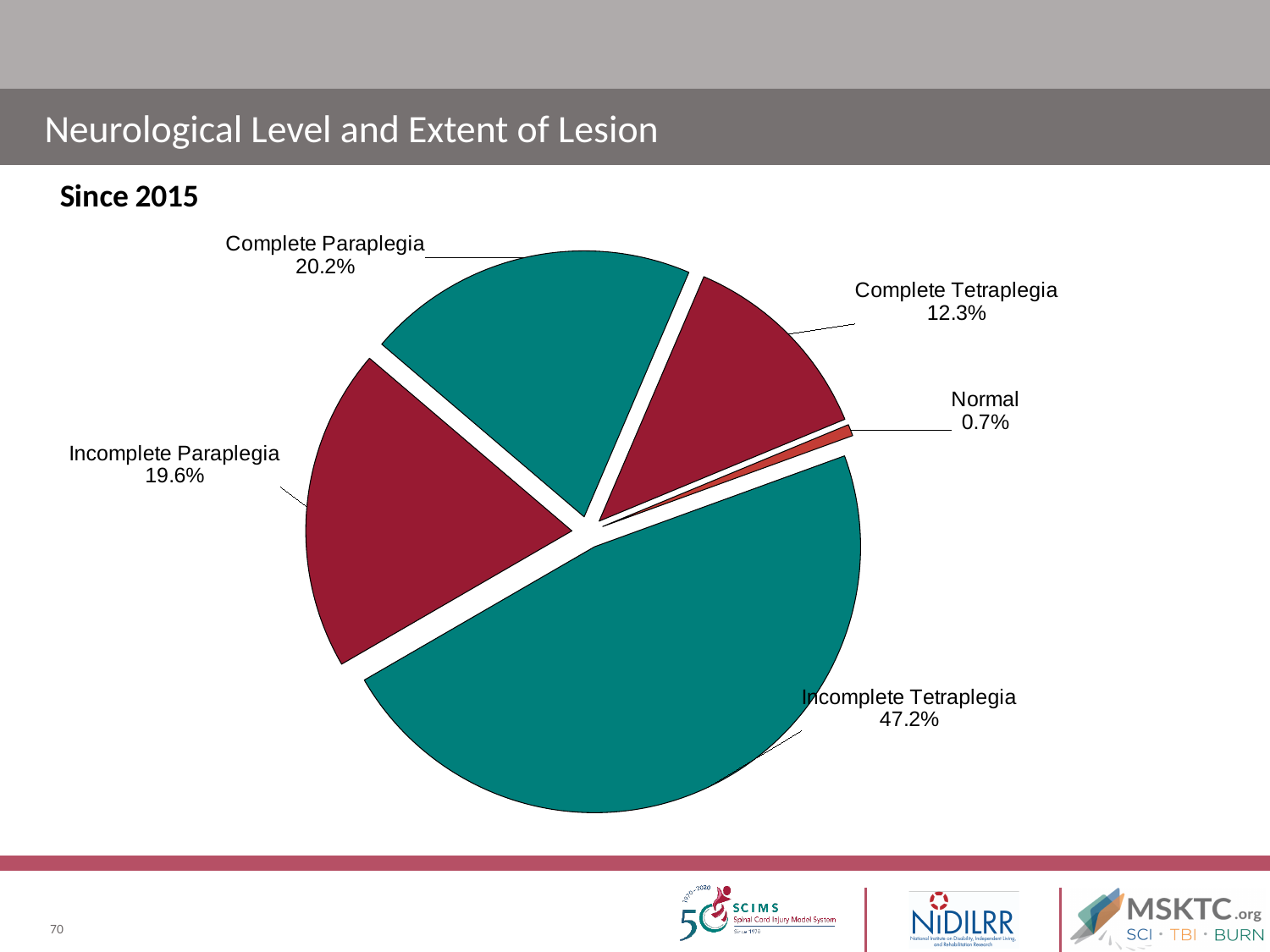
What is the difference in percentage points between Incomplete Tetraplegia and Complete Tetraplegia? 34.9 What percentage of the pie is Incomplete Tetraplegia? 47.2% Which is larger, Complete Tetraplegia or Incomplete Paraplegia? Incomplete Paraplegia What percentage of the pie is Incomplete Paraplegia? 19.6% What percentage of the pie is Normal? 0.7% What type of chart is shown on the slide? Pie chart What percentage of the pie is Complete Tetraplegia? 12.3% Which category has the smallest share of the pie? Normal Which category has the largest share of the pie? Incomplete Tetraplegia How many slices does the pie chart have? 5 What time period does the chart cover, according to the subtitle? Since 2015 What percentage of the pie is Complete Paraplegia? 20.2%